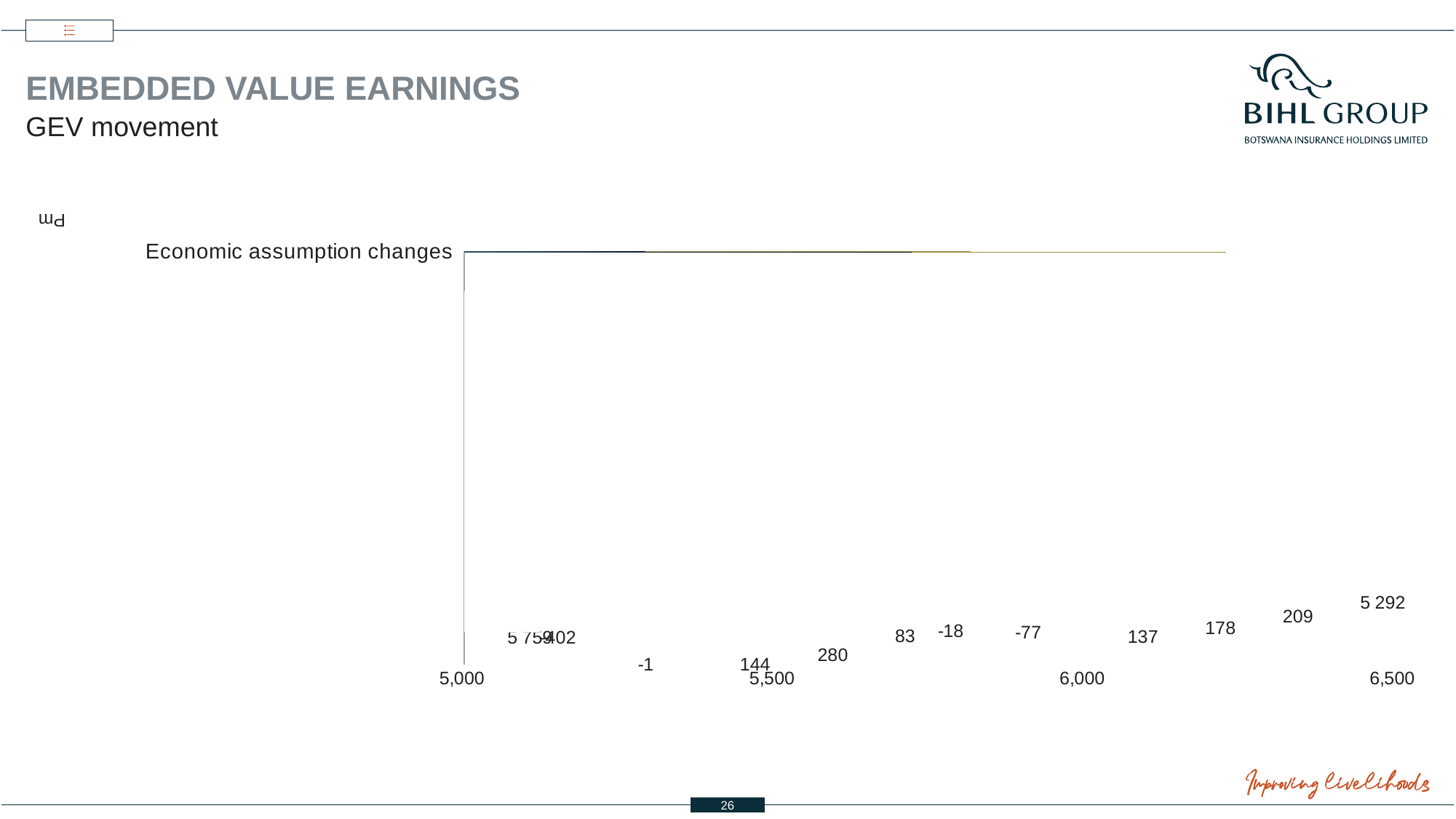
What unit label is shown on the chart's axis? Pm What is the highest tick value shown on the horizontal axis? 6,500 What is the rightmost data label shown on the chart? 5 292 What is the lowest tick value shown on the horizontal axis? 5,000 How many tick labels are shown on the horizontal axis of the chart? 4 What is the only category label readable on the chart? Economic assumption changes What is the lowest data label value shown on the chart? -77 How many negative data labels are shown on the chart? 3